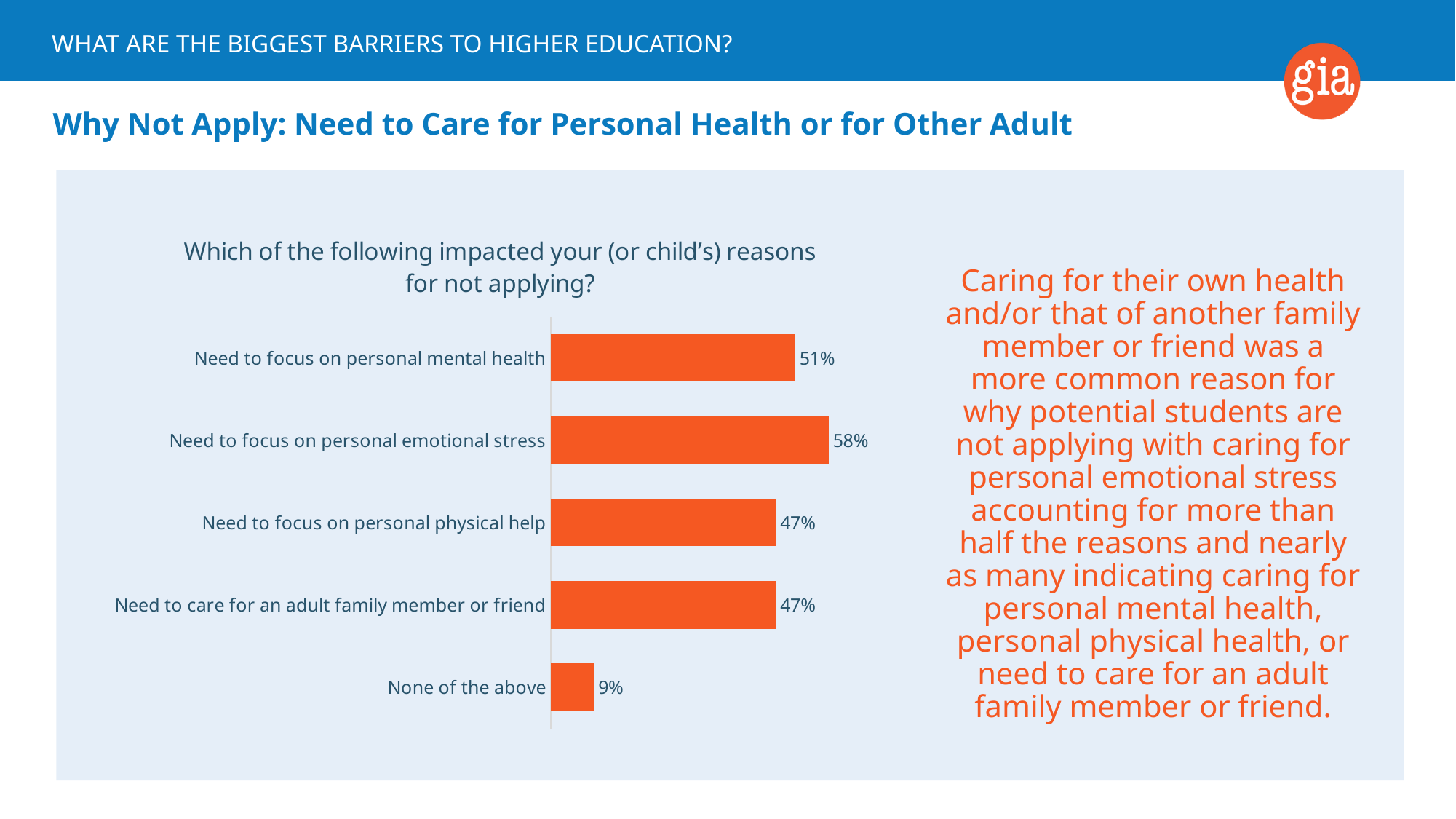
What question is the chart titled with? Which of the following impacted your (or child's) reasons for not applying? What is the value for "Need to focus on personal emotional stress"? 58% What is the difference between "Need to focus on personal emotional stress" and "Need to focus on personal mental health"? 7% What kind of chart is shown on the slide? Bar chart What percentage is shown for "None of the above"? 9% What percentage of respondents selected "Need to focus on personal mental health"? 51% Which is larger: "Need to focus on personal mental health" or "Need to focus on personal physical help"? Need to focus on personal mental health How many categories are shown in the chart? 5 What is the value for "Need to care for an adult family member or friend"? 47% Which category has the highest value? Need to focus on personal emotional stress What is the difference between "Need to focus on personal emotional stress" and "None of the above"? 49% Which category has the lowest value? None of the above